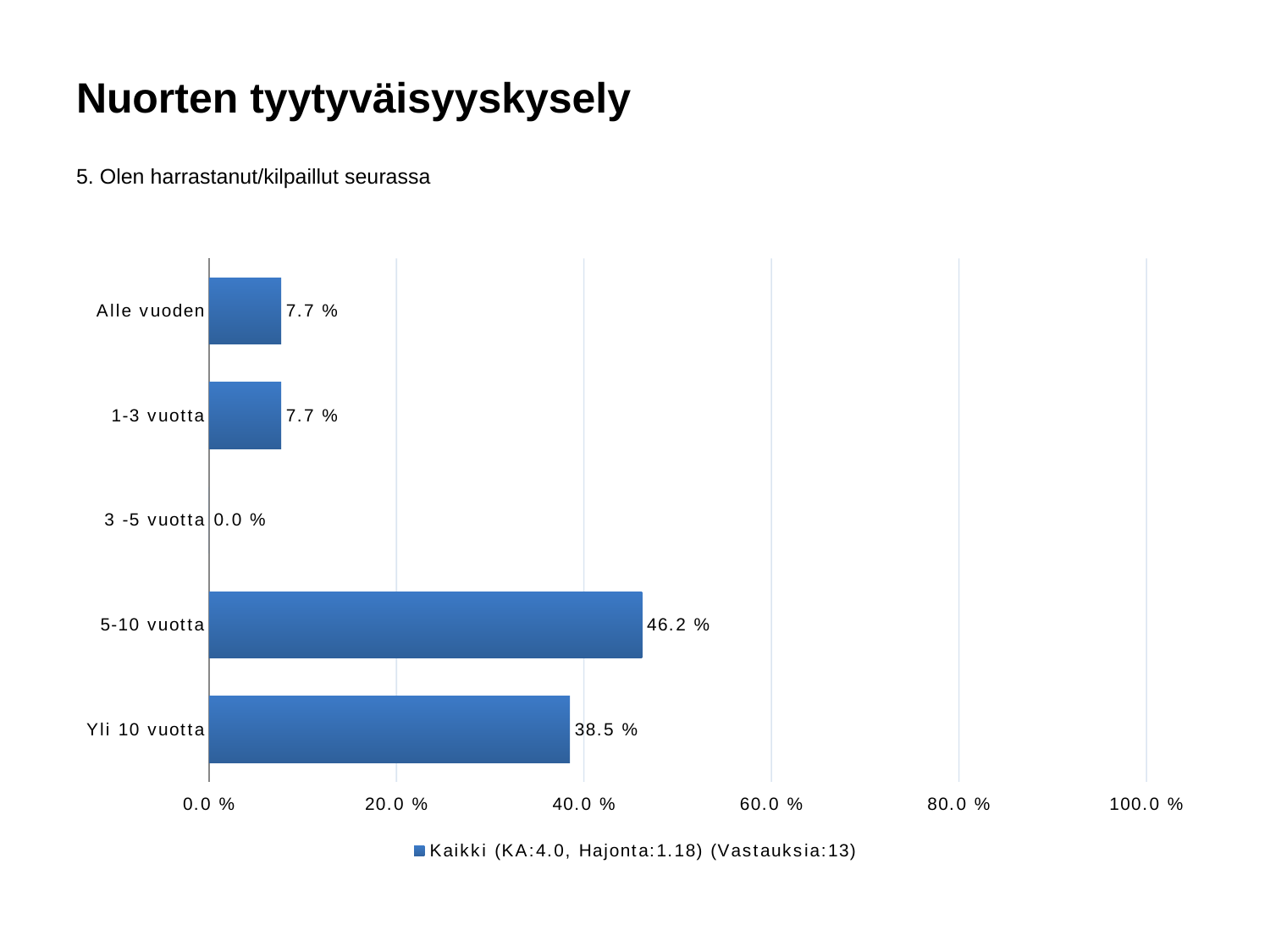
What is the difference between the values for 5-10 vuotta and Yli 10 vuotta? 7.7 % What kind of chart is shown on the slide? bar chart What is the value for 5-10 vuotta? 46.2 % How many responses (Vastauksia) does the legend entry report? 13 How many categories are shown on the chart? 5 What is the value for Yli 10 vuotta? 38.5 % Is the value for Yli 10 vuotta greater or less than 20.0 %? greater Which category has the highest value? 5-10 vuotta Which category has the lowest value? 3 -5 vuotta What is the value for 3 -5 vuotta? 0.0 % What is the value for Alle vuoden? 7.7 % Which is larger, the value for 5-10 vuotta or the value for Yli 10 vuotta? 5-10 vuotta